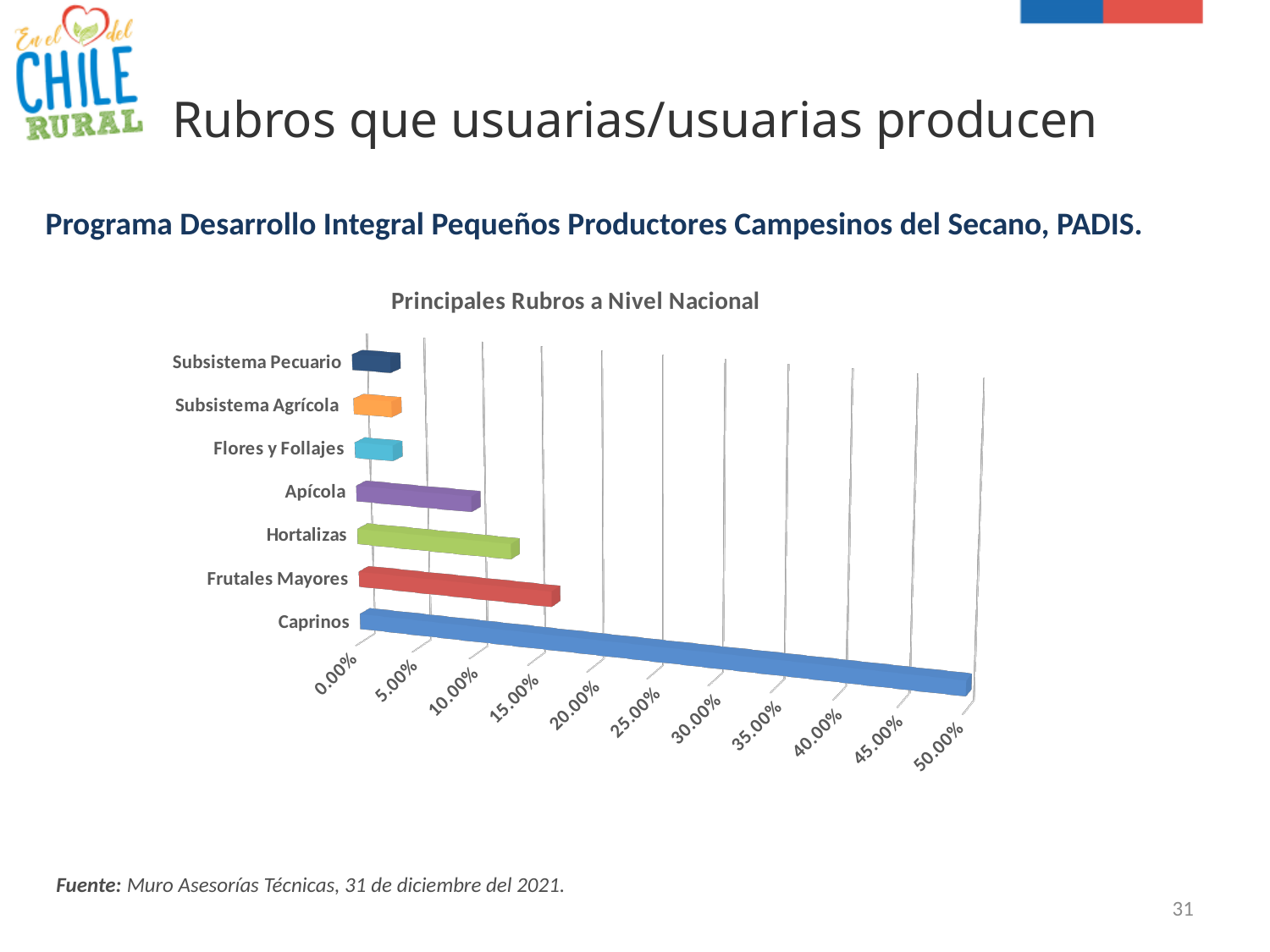
Which category has the highest value in the chart? Caprinos Which has a larger value, Apícola or Hortalizas? Hortalizas Is the value for Caprinos greater or less than 40.00%? greater What is the title of the chart? Principales Rubros a Nivel Nacional Which category is listed at the top of the chart's vertical axis? Subsistema Pecuario What type of chart is shown on the slide? Bar chart Which has a larger value, Frutales Mayores or Hortalizas? Frutales Mayores Is the value for Hortalizas greater or less than 20.00%? less Is the value for Apícola greater or less than 15.00%? less How many categories are plotted in the chart? 7